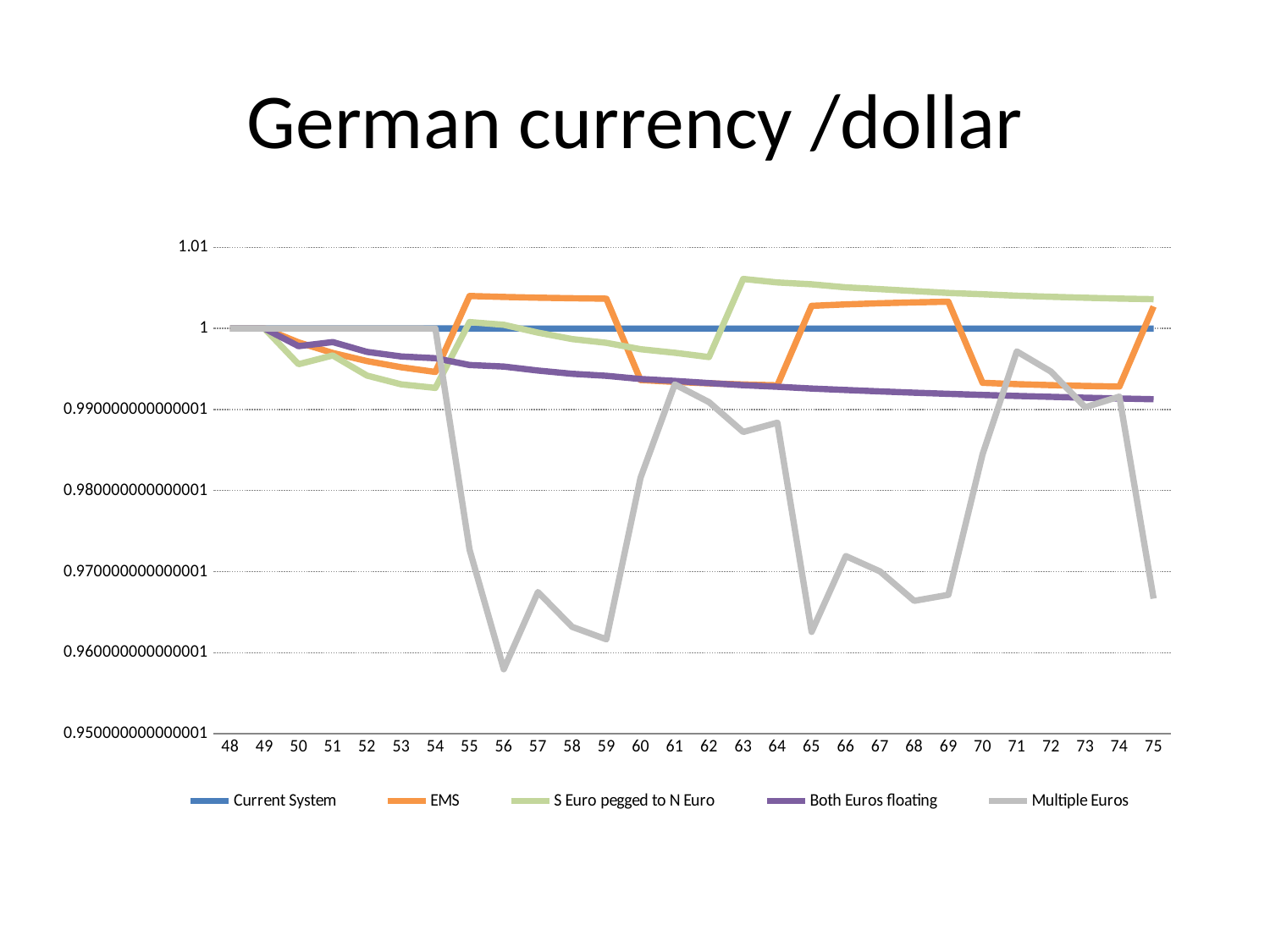
What is the value of the Multiple Euros series at 50? 1 Which series has the lowest value at 56? Multiple Euros How many points are plotted along the x axis (from 48 to 75)? 28 Which series has the highest value at 63? S Euro pegged to N Euro Is the value for Multiple Euros at 65 greater or less than 0.97? less What is the value of the Current System series at 60? 1 What kind of chart is shown on the slide? line chart How many series does the legend list? 5 Is the value for Multiple Euros at 56 greater or less than 0.96? less Is the value for Both Euros floating at 60 greater or less than 0.99? greater What is the title of the chart? German currency /dollar At 55, which is larger: EMS or Both Euros floating? EMS